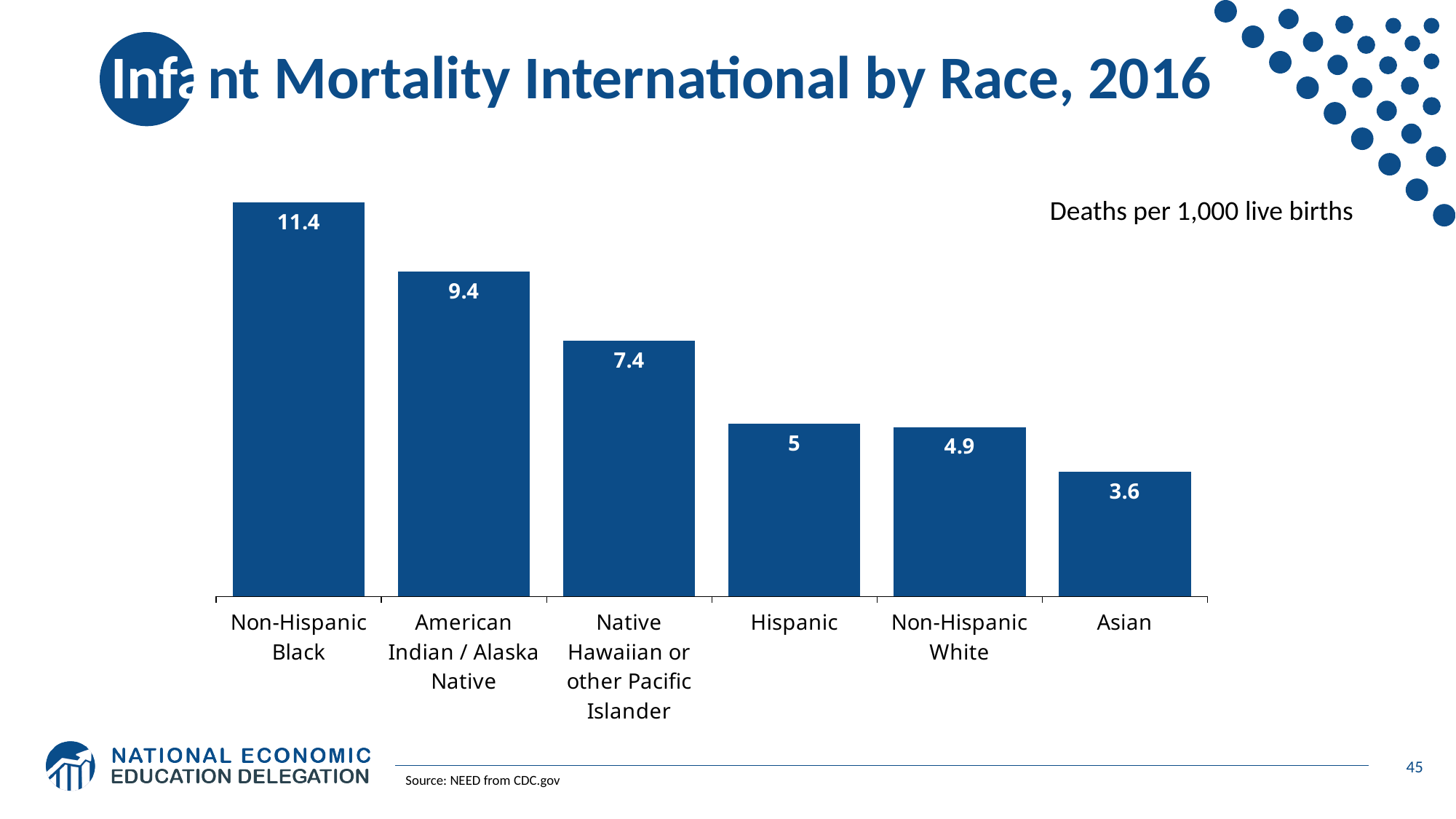
Which has a higher infant mortality rate, American Indian / Alaska Native or Native Hawaiian or other Pacific Islander? American Indian / Alaska Native What is the infant mortality rate for Native Hawaiian or other Pacific Islander? 7.4 What is the infant mortality rate for Asian? 3.6 What is the infant mortality rate for Hispanic? 5 What unit are the values in the chart measured in? Deaths per 1,000 live births How many racial groups are shown in the chart? 6 What is the difference between the infant mortality rates for Non-Hispanic Black and Non-Hispanic White? 6.5 What is the infant mortality rate for Non-Hispanic Black? 11.4 What kind of chart is shown on the slide? Bar chart Which group has the lowest infant mortality rate? Asian What is the infant mortality rate for American Indian / Alaska Native? 9.4 Which group has the highest infant mortality rate? Non-Hispanic Black